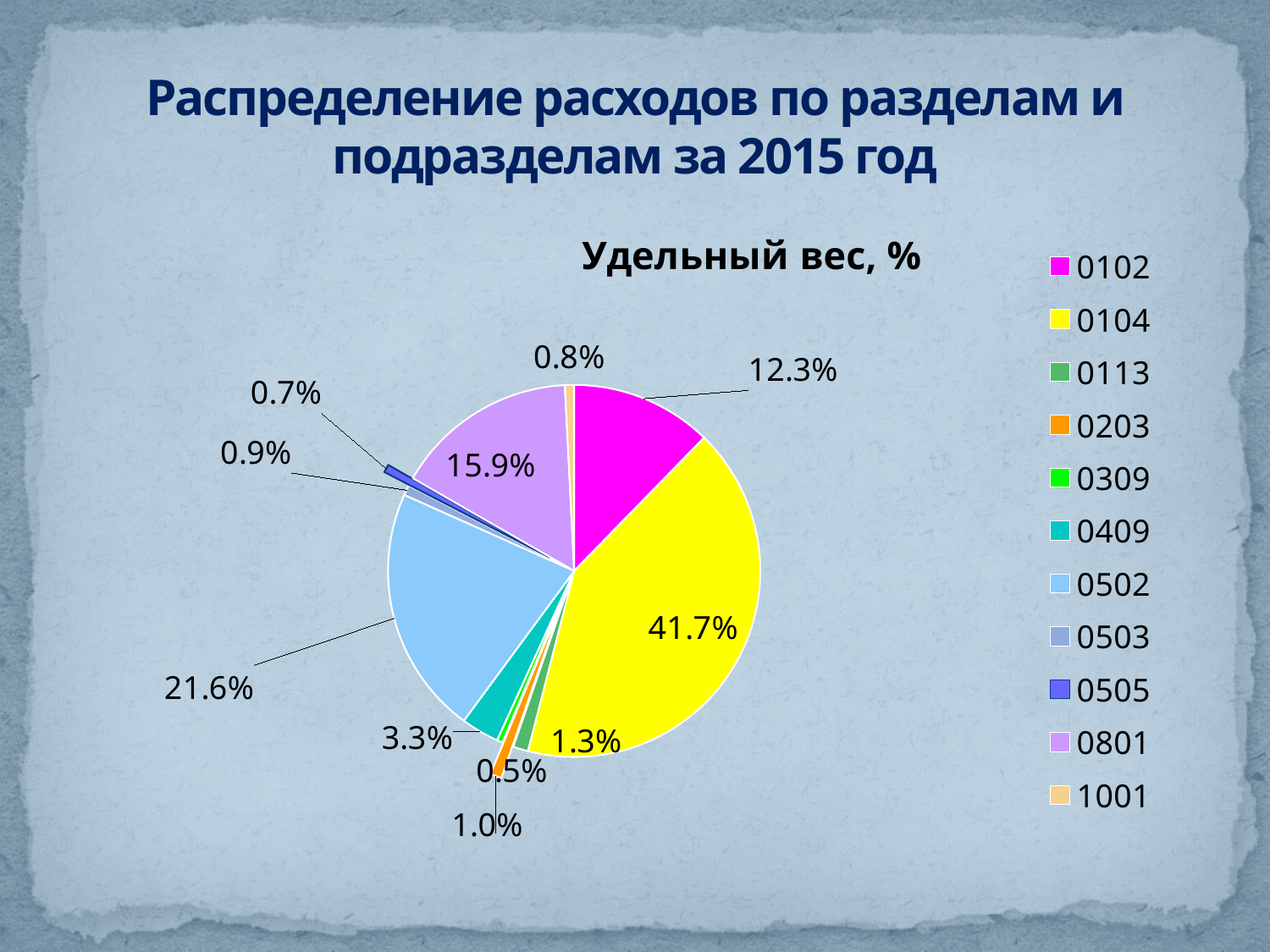
What is the title of the chart? Удельный вес, % What is the share for category 0104? 41.7% What is the share for category 0102? 12.3% How many categories does the legend list? 11 What is the share for category 0801? 15.9% What type of chart is shown on the slide? pie chart What is the difference between the shares for 0104 and 0502? 20.1% What colour is the slice for category 0104? yellow What is the share for category 0409? 3.3% What is the share for category 0502? 21.6% Which is larger, the share for 0502 or the share for 0801? 0502 Which category has the largest share of the pie? 0104